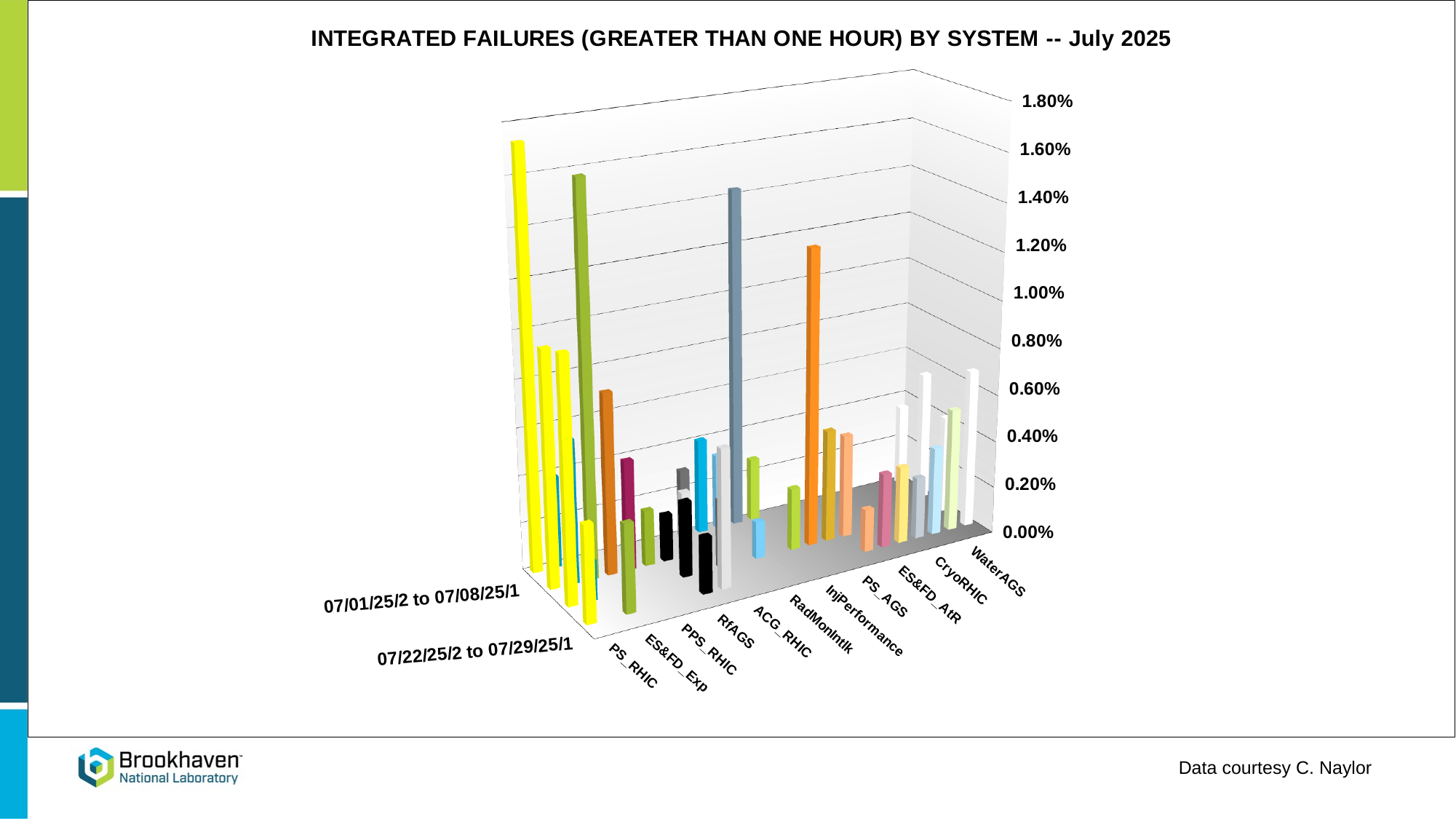
What is the title of the chart? INTEGRATED FAILURES (GREATER THAN ONE HOUR) BY SYSTEM -- July 2025 Is the tallest bar for ES&FD_Exp greater or less than 1.00%? greater Is the tallest bar for PS_AGS greater or less than 0.80%? less Is the tallest bar for InjPerformance greater or less than 0.60%? less Which system has the tallest bar in the chart? PS_RHIC What kind of chart is shown on the slide? bar chart How many systems (categories) are listed along the horizontal axis of the chart? 11 What is the highest value shown on the vertical axis of the chart? 1.80% Which system has a taller tallest bar, PS_RHIC or RfAGS? PS_RHIC